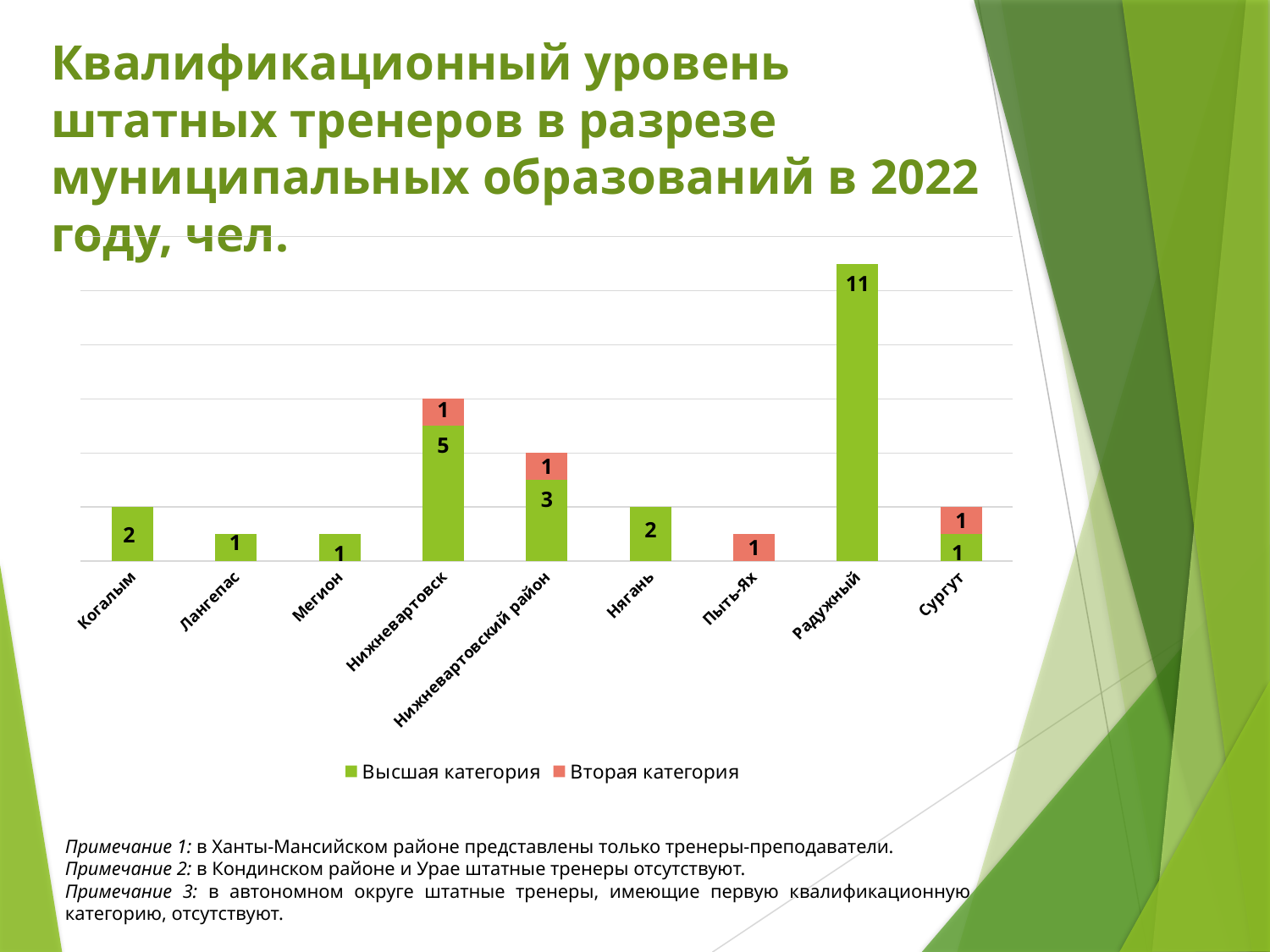
How many municipalities (categories) are shown on the x axis? 9 What is the value of Высшая категория for Радужный? 11 What is the value of Высшая категория for Нижневартовск? 5 What kind of chart is shown on the slide? Stacked bar chart What is the value of Вторая категория for Пыть-Ях? 1 Which is larger: the Высшая категория value for Когалым or for Лангепас? Когалым What is the difference between the Высшая категория values for Радужный and Нижневартовск? 6 How many series does the legend list? 2 What is the total of the stacked bar for Нижневартовский район? 4 What is the total of the stacked bar for Нижневартовск? 6 Which series is shown in green in the legend? Высшая категория Which municipality has the highest value of Высшая категория? Радужный